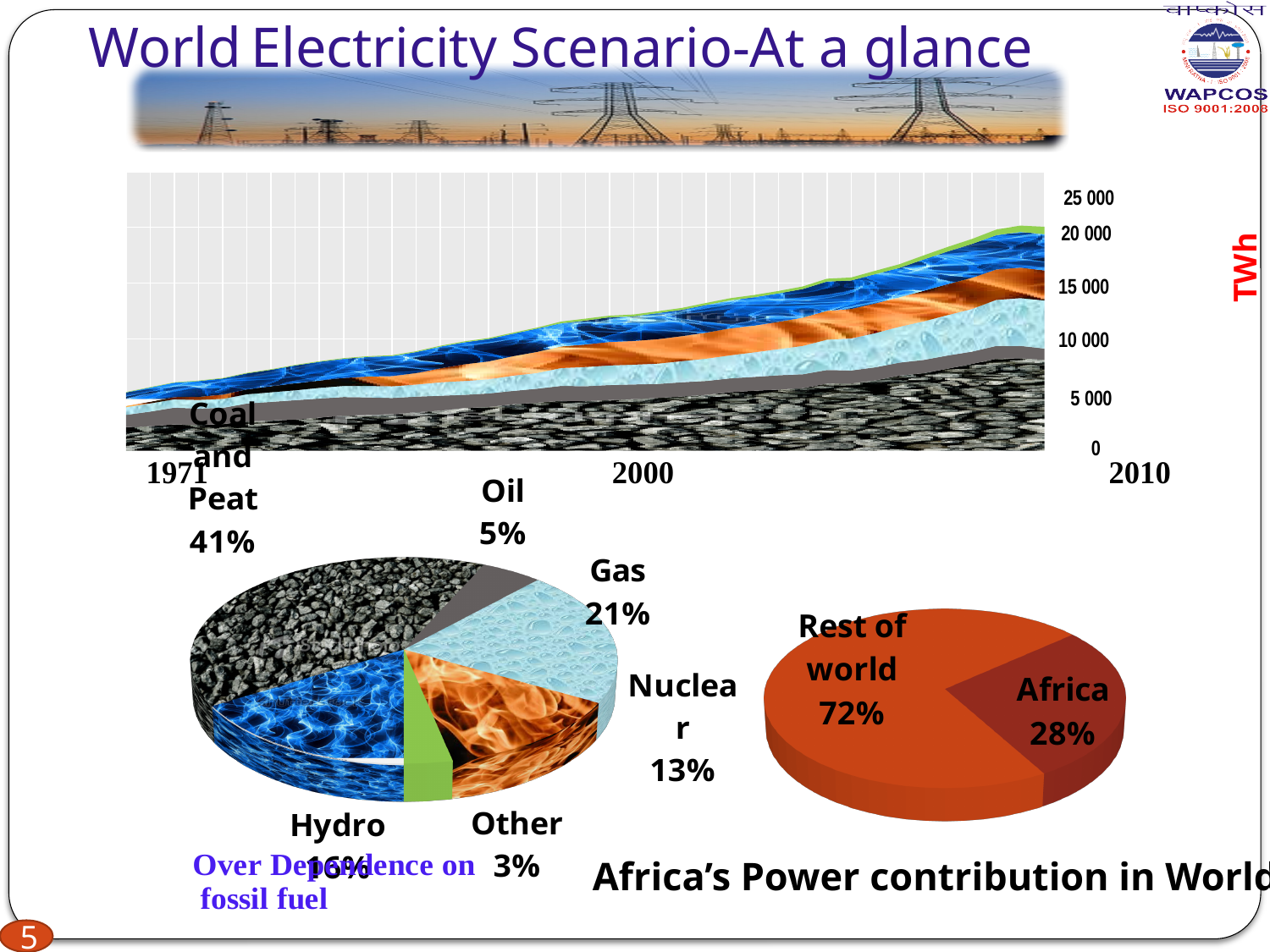
In the fuel-mix pie chart on the lower left, what share is labelled for Coal and Peat? 41% In the fuel-mix pie chart on the lower left, what share is labelled for Gas? 21% In the fuel-mix pie chart on the lower left, which category has the smallest share? Other In the top area chart, does total electricity generation rise or fall from 1971 to 2010? Rise What kind of chart is the top chart showing electricity from 1971 to 2010? Area chart In the fuel-mix pie chart on the lower left, which is larger, Oil or Nuclear? Nuclear In the fuel-mix pie chart on the lower left, what share is labelled for Nuclear? 13% How many slices does the 'Africa's Power contribution in World' pie chart have? 2 In the fuel-mix pie chart on the lower left, which fuel has the largest share? Coal and Peat In the fuel-mix pie chart on the lower left, how many percentage points larger is Gas than Nuclear? 8 percentage points In the 'Africa's Power contribution in World' pie chart, what share is labelled for Africa? 28% In the 'Africa's Power contribution in World' pie chart, what share is labelled for Rest of world? 72%